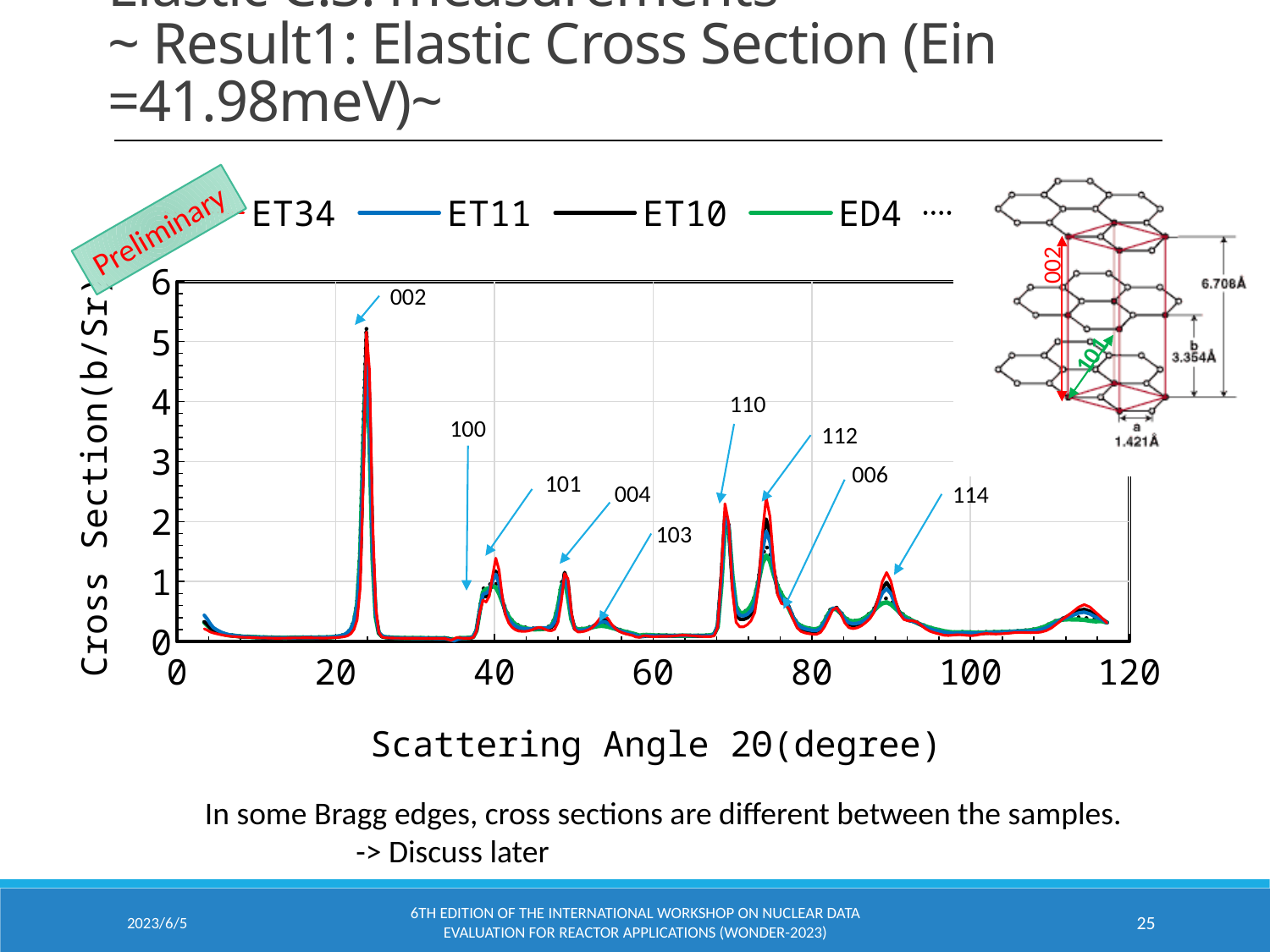
Is the cross section at the 002 peak greater or less than 4 b/Sr? greater What kind of chart is shown on the slide? line chart What is the maximum value shown on the y axis? 6 What is the label of the x axis? Scattering Angle 2θ(degree) Which peak has a larger cross section, 002 or 110? 002 Which sample is plotted with the blue line according to the legend? ET11 Is the cross section at the 103 peak greater or less than 1 b/Sr? less Which peak has a larger cross section, 112 or 103? 112 Which labeled Bragg peak has the highest cross section? 002 How many Bragg peaks are labeled with Miller indices on the chart? 9